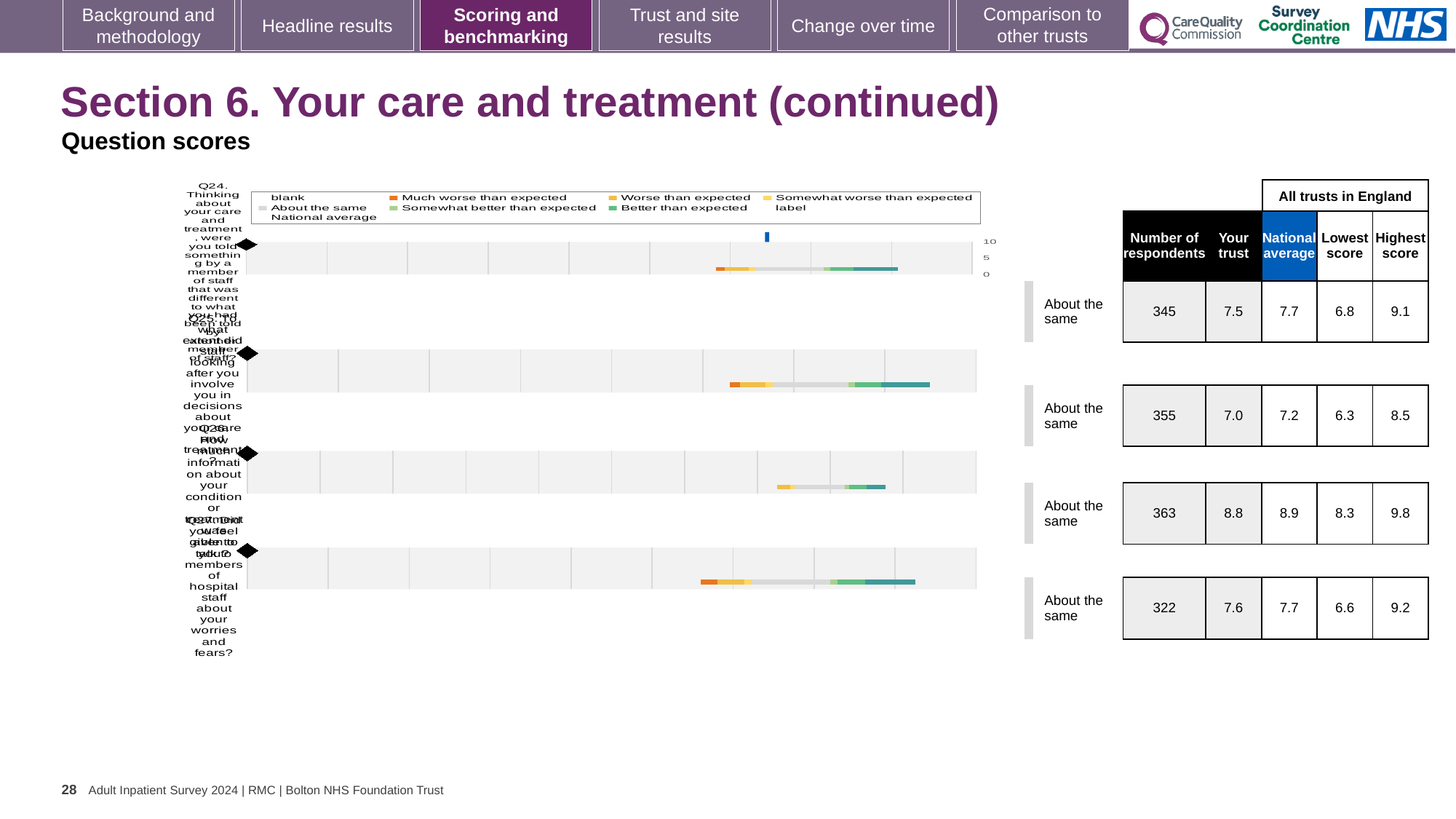
Which question number is shown in the topmost chart on the slide? Q24 What is the 'Your trust' score shown for Q24? 7.5 For Q26, which is larger: the 'Your trust' score or the national average? national average What is the highest score across all trusts in England shown for Q27? 9.2 What is the national average score shown for Q26? 8.9 What benchmark category is shown next to the Q25 chart? About the same Which question has the lowest number of respondents? Q27 In the chart legend, what colour represents 'Much worse than expected'? orange How many separate benchmarking charts are shown on the slide? 4 How many respondents are shown for Q25? 355 What kind of chart is used for the Q24 benchmarking display? bar chart What is the difference between the national average and the 'Your trust' score for Q25? 0.2